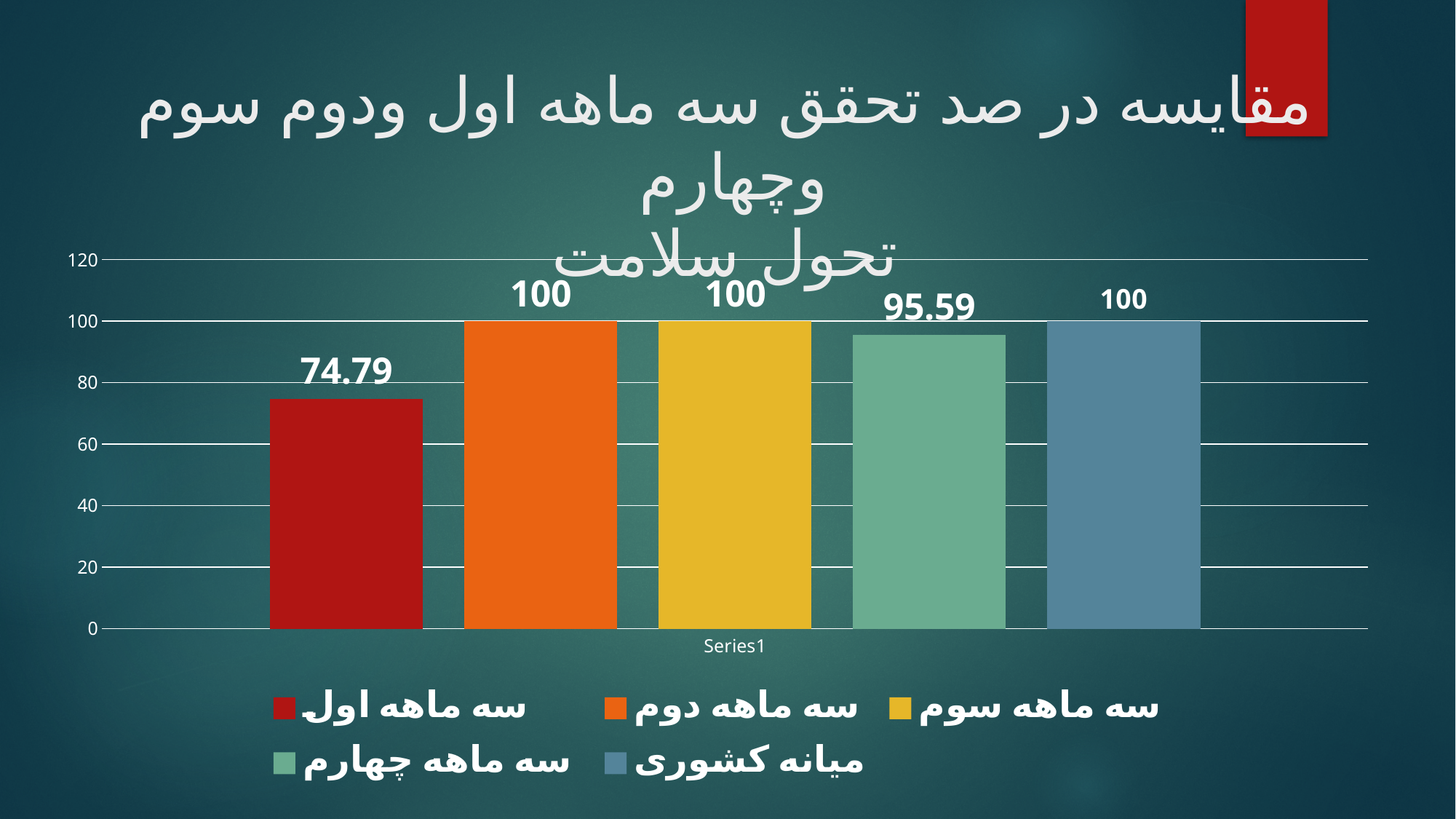
What type of chart is shown on the slide? bar chart Which category has the lowest value? سه ماهه اول What is the value for میانه کشوری? 100 What is the difference between the values for میانه کشوری and سه ماهه چهارم? 4.41 What is the value for سه ماهه دوم? 100 What is the value for سه ماهه اول? 74.79 How many entries does the legend list? 5 What is the value for سه ماهه چهارم? 95.59 How many bars are plotted in the chart? 5 Is the value for سه ماهه اول greater or less than 80? less Which is larger, the value for سه ماهه سوم or the value for سه ماهه چهارم? سه ماهه سوم What is the difference between the values for سه ماهه دوم and سه ماهه اول? 25.21